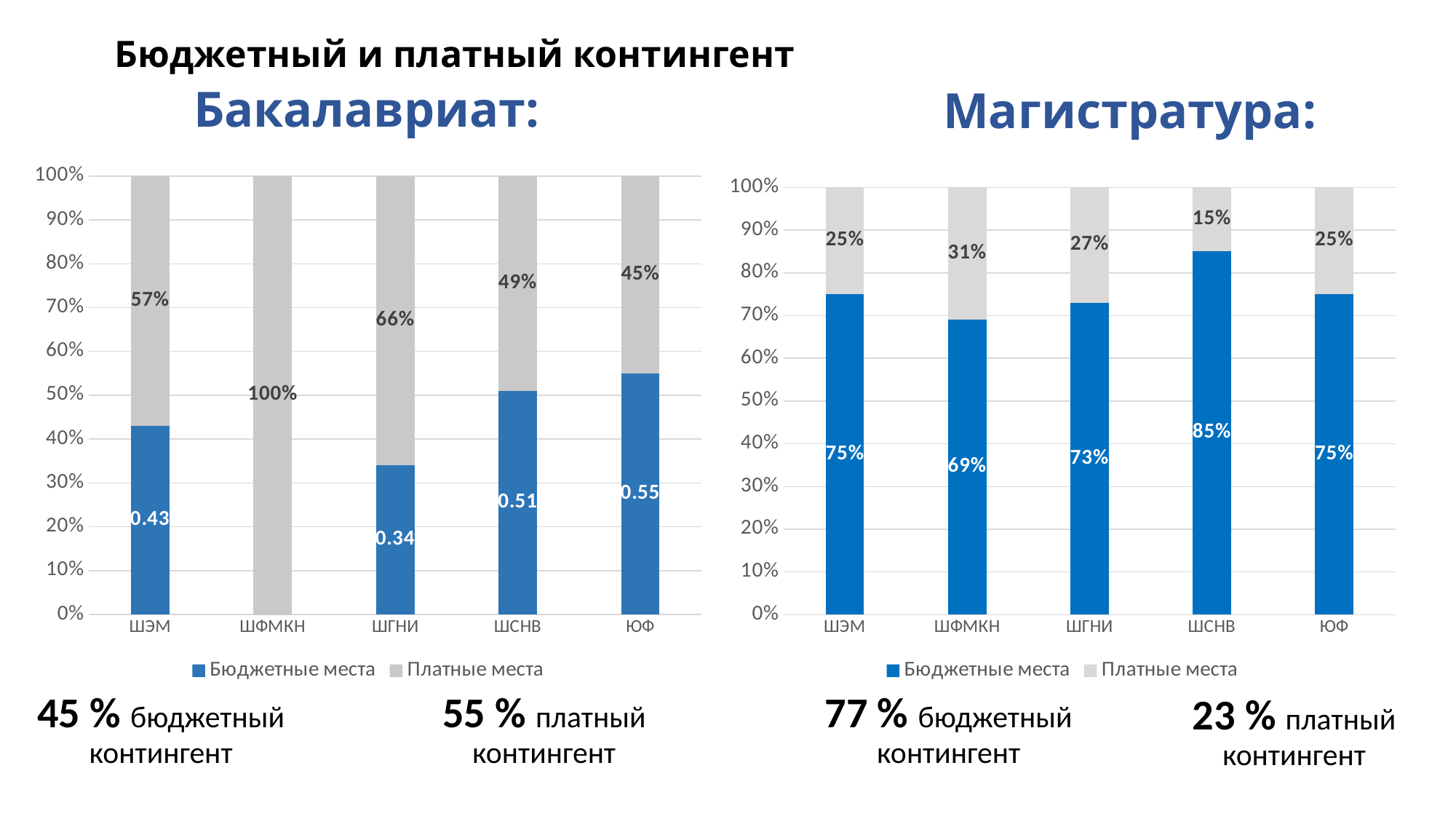
On the Бакалавриат chart, which category has the highest share of Платные места? ШФМКН On the Магистратура chart, is the Бюджетные места value larger for ШГНИ or for ШФМКН? ШГНИ What kind of chart is the Бакалавриат chart? Stacked bar chart On the Магистратура chart, what is the value of Платные места for ШФМКН? 31% On the Бакалавриат chart, what is the value of Платные места for ШГНИ? 66% On the Бакалавриат chart, which category has the lowest labelled value for Бюджетные места? ШГНИ On the Магистратура chart, what is the difference between the Бюджетные места values for ШСНВ and ШФМКН? 16% On the Бакалавриат chart, what is the value of Платные места for ШФМКН? 100% How many categories are shown on the x axis of the Магистратура chart? 5 On the Бакалавриат chart, what is the data label for Бюджетные места for ШЭМ? 0.43 On the Магистратура chart, what is the value of Бюджетные места for ШСНВ? 85% On the Магистратура chart, which category has the lowest share of Платные места? ШСНВ